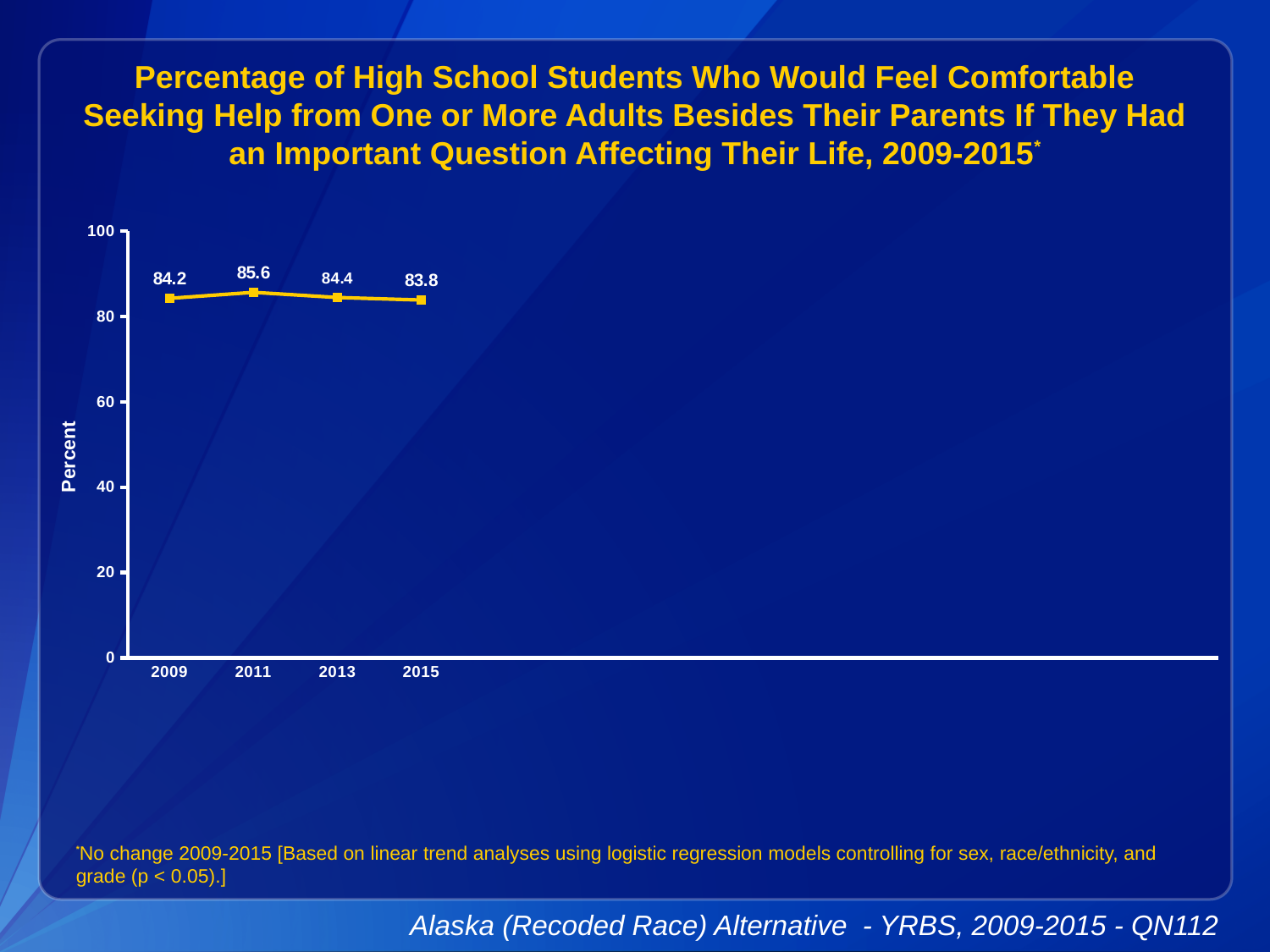
Is the value for 2013 greater or less than 80? greater What kind of chart is shown on the slide? line chart What is the difference between the values for 2011 and 2015? 1.8 Which year has the lowest value? 2015 What is the value for 2015? 83.8 What is the value for 2011? 85.6 Which year has the highest value? 2011 What is the value for 2009? 84.2 What is the value for 2013? 84.4 Which is larger, the value for 2009 or the value for 2011? 2011 What is the label on the y axis? Percent How many years are plotted on the chart? 4